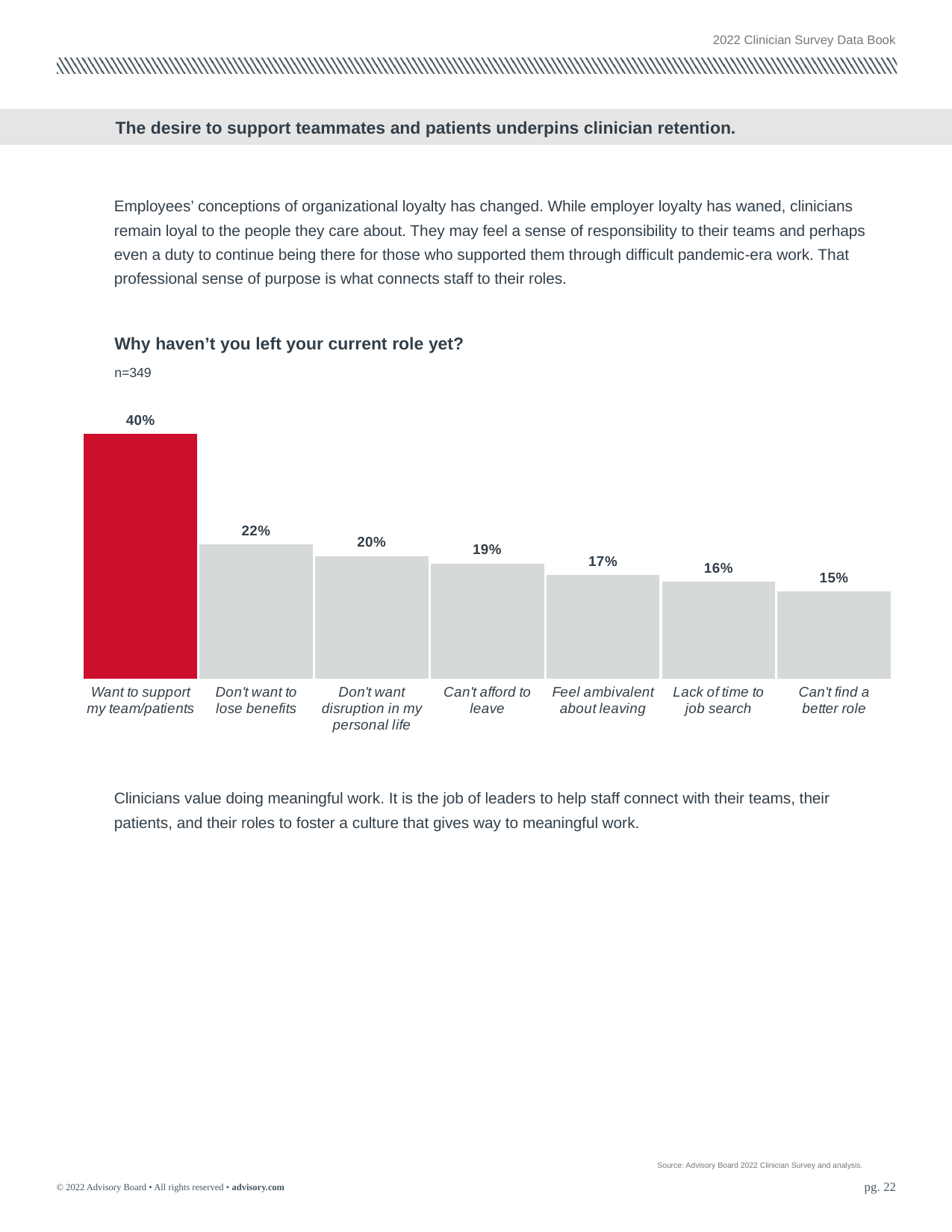
Which reason has the highest percentage? Want to support my team/patients What is the difference between "Don't want disruption in my personal life" and "Can't find a better role"? 5 percentage points Do the values rise or fall from left to right across the chart? Fall Which is larger: "Feel ambivalent about leaving" or "Lack of time to job search"? Feel ambivalent about leaving What is the value for "Can't afford to leave"? 19% Which bar is highlighted in red? Want to support my team/patients What percentage of respondents said they haven't left their current role because they want to support their team/patients? 40% What kind of chart is shown on the slide? Bar chart What is the difference between "Want to support my team/patients" and "Don't want to lose benefits"? 18 percentage points Which reason has the lowest percentage? Can't find a better role What percentage cited "Lack of time to job search"? 16% How many reasons (categories) are shown in the chart? 7